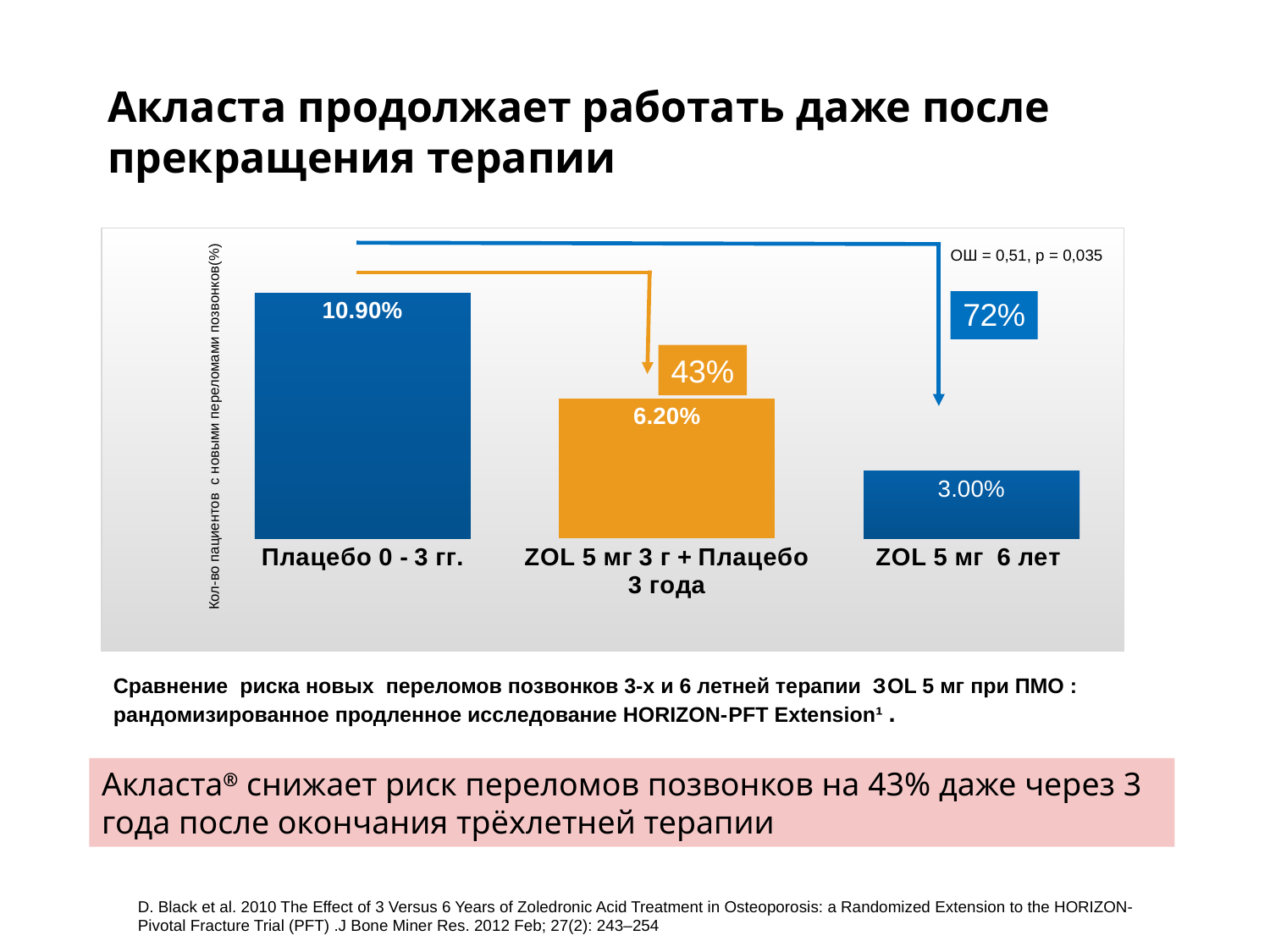
What is the difference between the "ZOL 5 мг 3 г + Плацебо 3 года" bar and the "ZOL 5 мг 6 лет" bar? 3.20% How many bars are shown in the chart? 3 What is the difference between the "Плацебо 0 - 3 гг." bar and the "ZOL 5 мг 3 г + Плацебо 3 года" bar? 4.70% What percentage reduction is shown in the label above the "ZOL 5 мг 6 лет" bar? 72% What is the value for the "ZOL 5 мг 6 лет" bar? 3.00% Which category has the lowest value? ZOL 5 мг 6 лет What is the value for the "ZOL 5 мг 3 г + Плацебо 3 года" bar? 6.20% What is the value for the "Плацебо 0 - 3 гг." bar? 10.90% Which is larger, the value for "ZOL 5 мг 3 г + Плацебо 3 года" or the value for "ZOL 5 мг 6 лет"? ZOL 5 мг 3 г + Плацебо 3 года Which category has the highest value? Плацебо 0 - 3 гг. What kind of chart is shown on the slide? Bar chart Do the bar values rise or fall from left to right across the categories? Fall